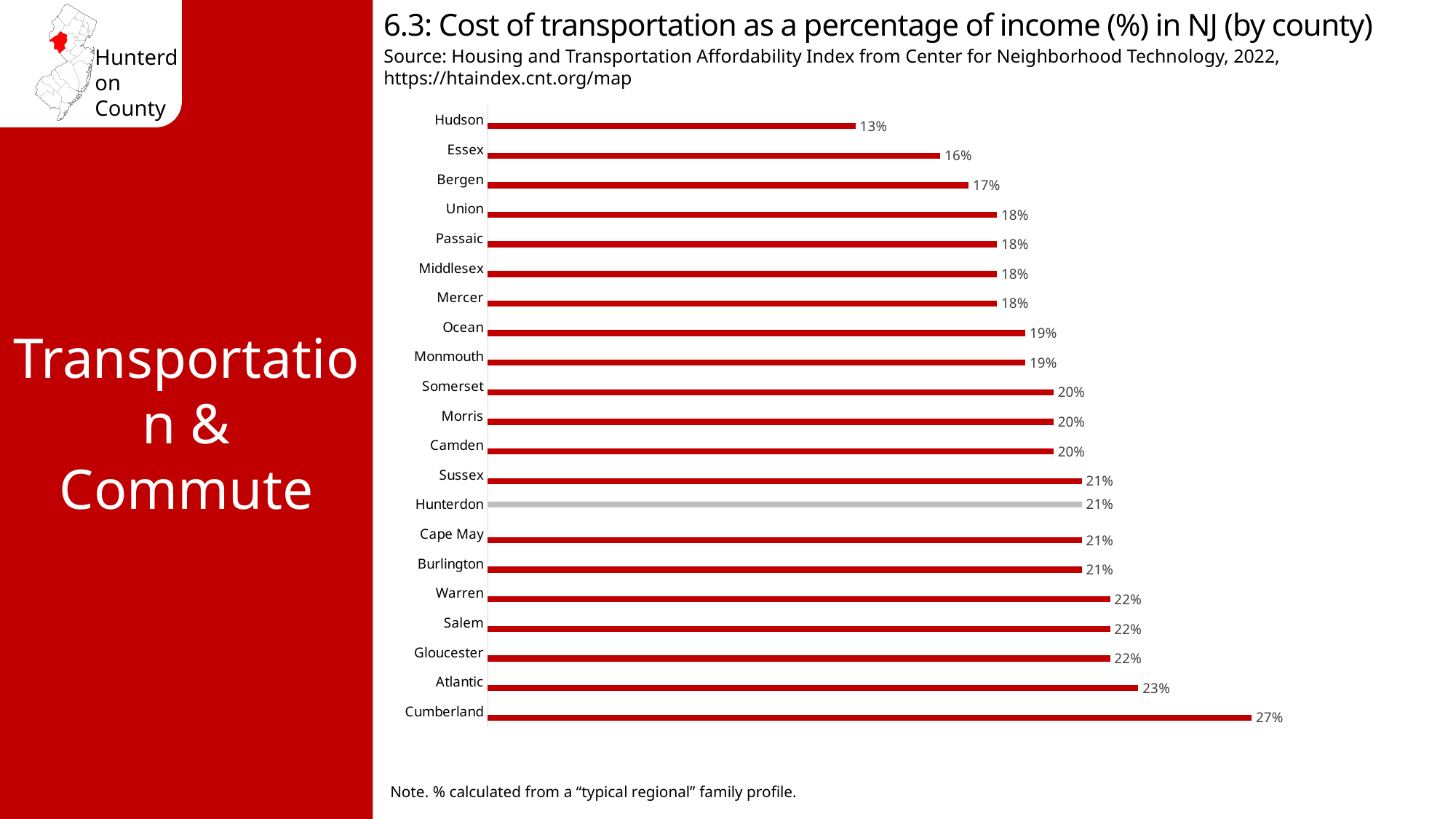
How many counties are shown in the chart? 21 What is the value shown for Atlantic County? 23% What is the cost of transportation as a percentage of income for Hunterdon County? 21% Which county has the lowest cost of transportation as a percentage of income? Hudson What is the cost of transportation as a percentage of income for Hudson County? 13% What is the difference between the values for Cumberland and Hudson? 14% Which county's bar is shown in grey instead of red? Hunterdon What type of chart is used on this slide? Bar chart Which county has the highest cost of transportation as a percentage of income? Cumberland Do the values increase or decrease going from the top bar (Hudson) to the bottom bar (Cumberland)? Increase Which county has a higher value, Bergen or Warren? Warren What is the difference between the values for Hunterdon and Essex? 5%